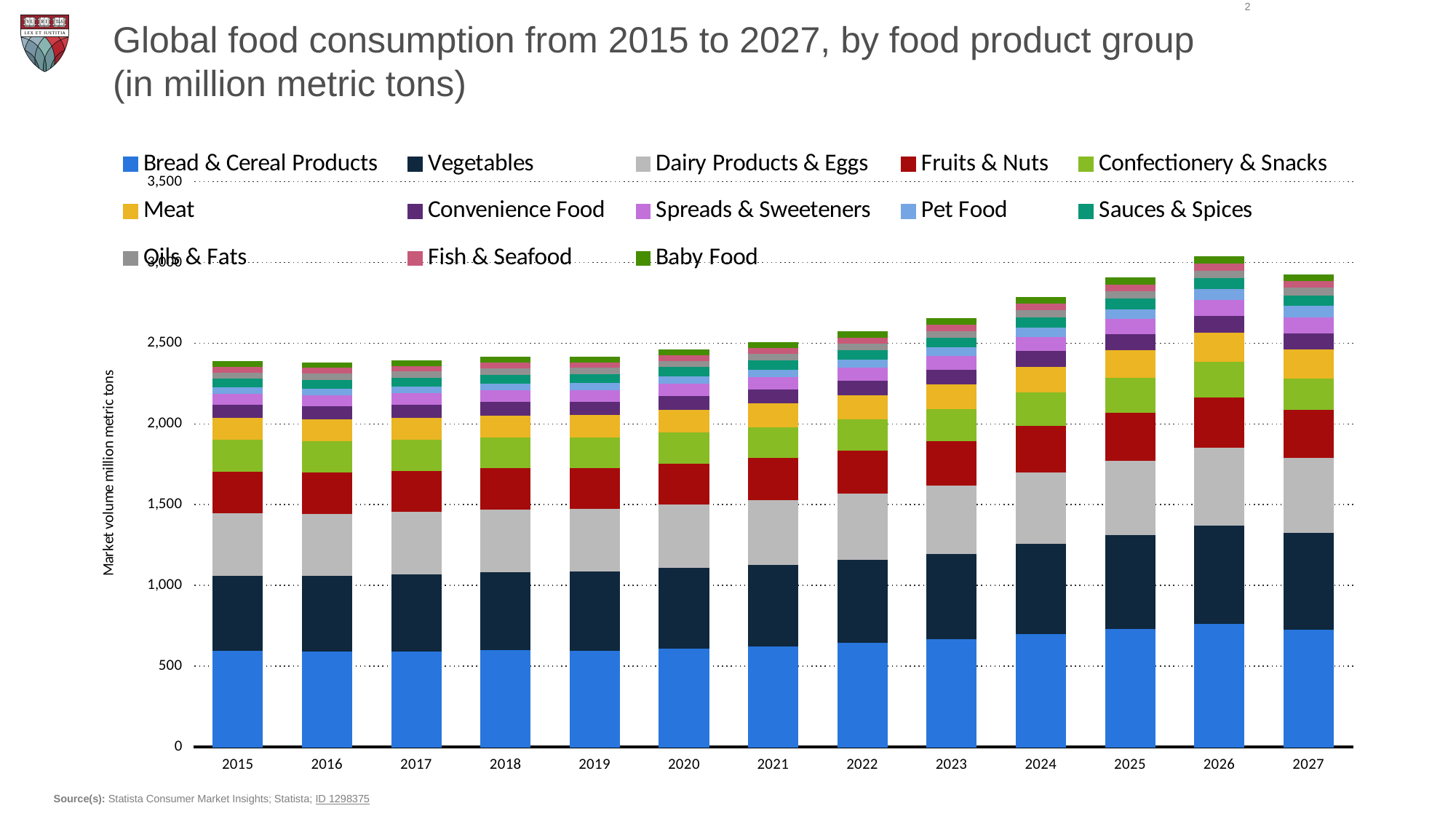
Do the total stacked bars generally rise or fall from 2015 to 2026? Rise Is the total stacked bar for 2026 taller or shorter than the bar for 2027? Taller Is the total value for 2027 greater or less than 2,500? greater Is the value for Bread & Cereal Products in 2026 greater or less than 500? greater Is the total value for 2015 greater or less than 2,500? less Which year has the larger total bar, 2015 or 2024? 2024 What kind of chart is shown on the slide? Stacked bar chart How many food product groups does the legend list? 13 Which year has the tallest stacked bar (highest total consumption)? 2026 How many years are shown along the x axis of the chart? 13 Which food product group is shown at the bottom of each stacked bar in blue? Bread & Cereal Products What is the label on the vertical axis of the chart? Market volume million metric tons